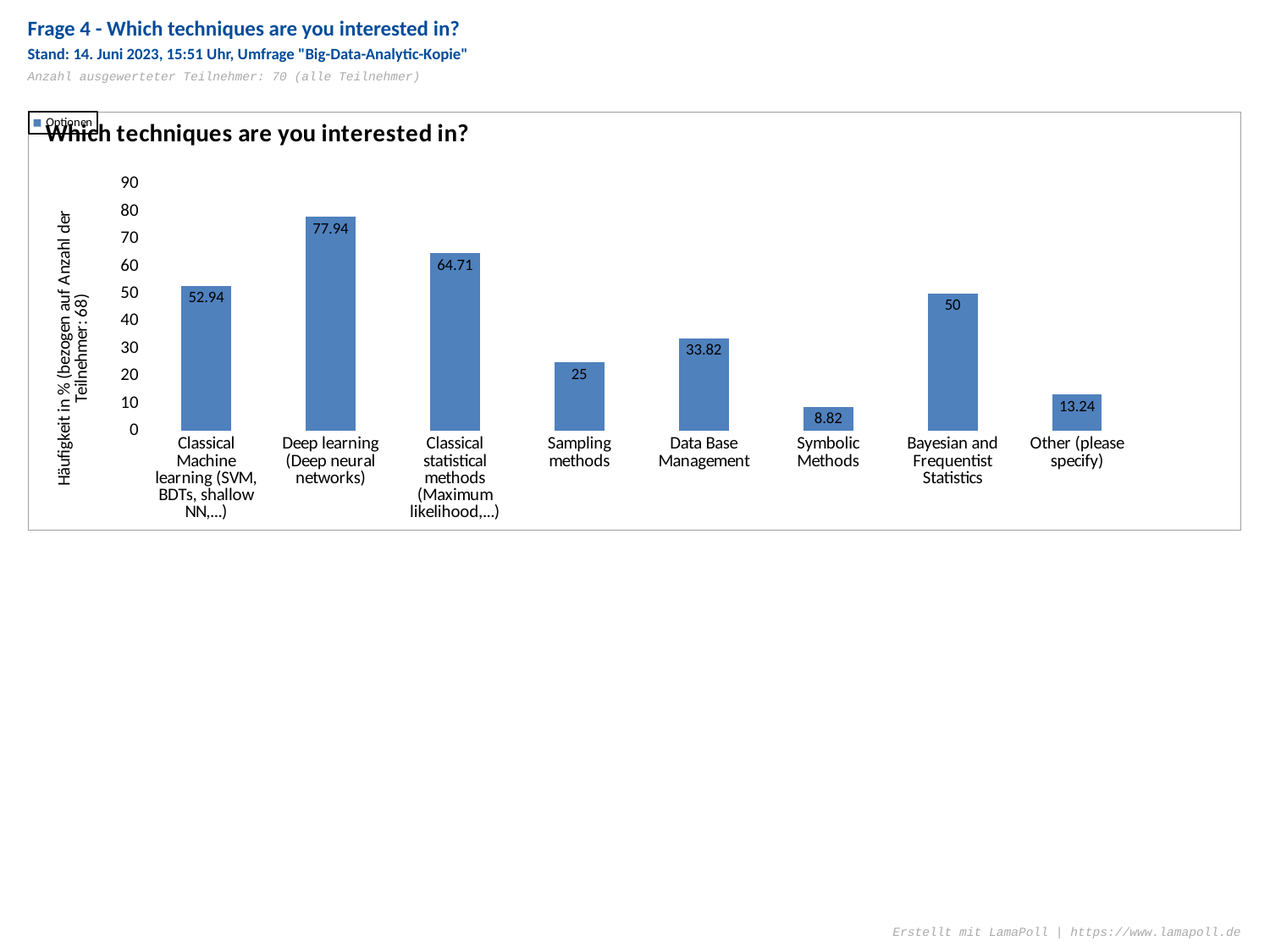
What kind of chart is shown? bar chart Is the value for Classical Machine learning (SVM, BDTs, shallow NN,...) greater or less than 50? greater Which is larger, the value for Data Base Management or the value for Other (please specify)? Data Base Management What is the title of the chart? Which techniques are you interested in? What is the value for Sampling methods? 25 What is the value for Bayesian and Frequentist Statistics? 50 Which category has the lowest value? Symbolic Methods What is the value for Deep learning (Deep neural networks)? 77.94 How many categories are shown on the x axis? 8 What is the difference between the values for Deep learning (Deep neural networks) and Classical statistical methods (Maximum likelihood,...)? 13.23 Which category has the highest value? Deep learning (Deep neural networks) How many series does the legend list? 1